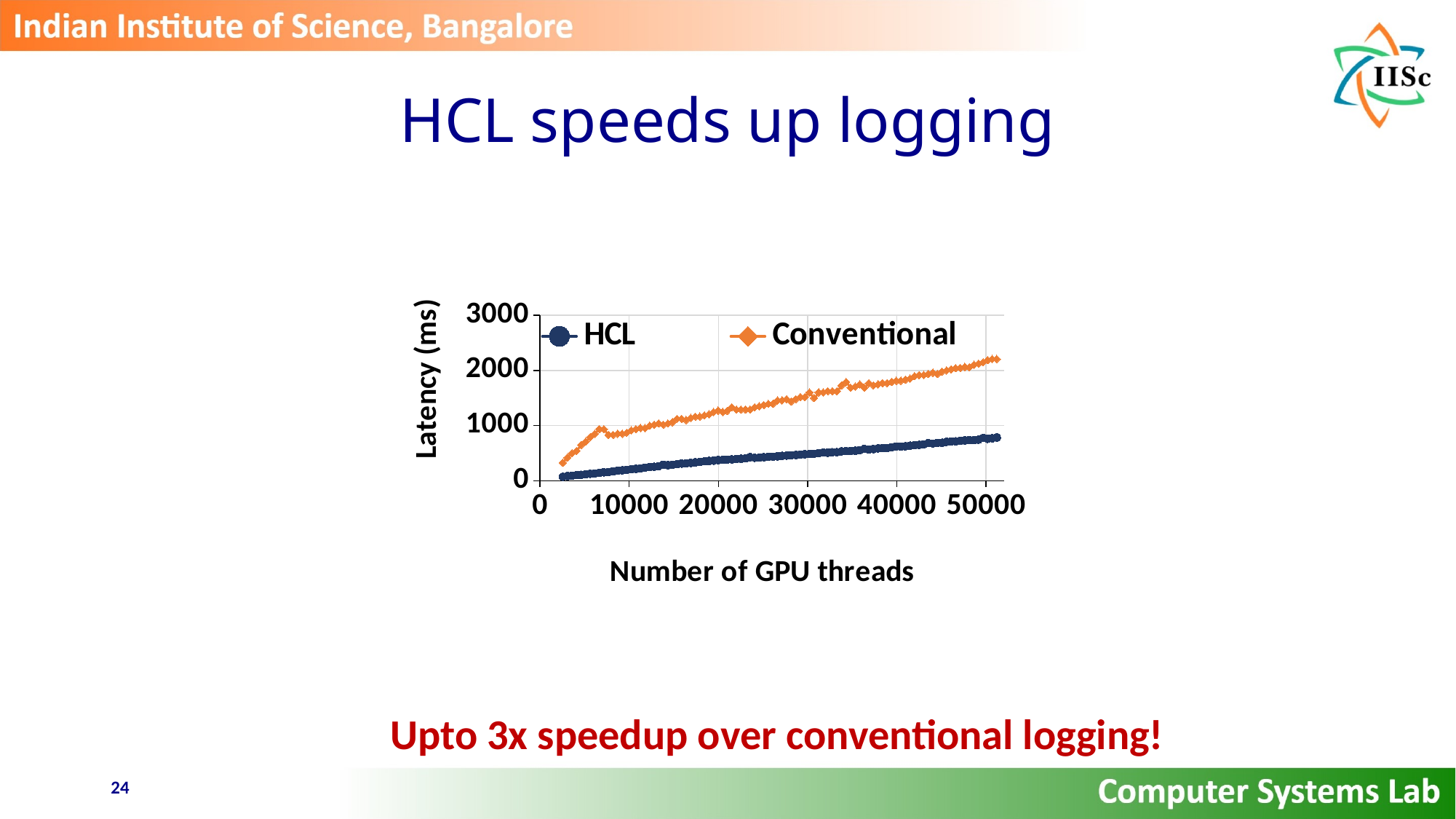
Does the HCL latency rise or fall as the number of GPU threads increases? rises Which series has the lower latency at 50000 GPU threads? HCL What is the label of the y axis? Latency (ms) Is the latency for HCL at 50000 GPU threads greater or less than 1000? less What kind of chart is shown on the slide? line chart How many series does the legend list? 2 Is the latency for HCL at 20000 GPU threads greater or less than 1000? less Is the latency for Conventional at 30000 GPU threads greater or less than 1000? greater Does the Conventional latency rise or fall as the number of GPU threads increases? rises What is the label of the x axis? Number of GPU threads Which series has the higher latency at 30000 GPU threads? Conventional